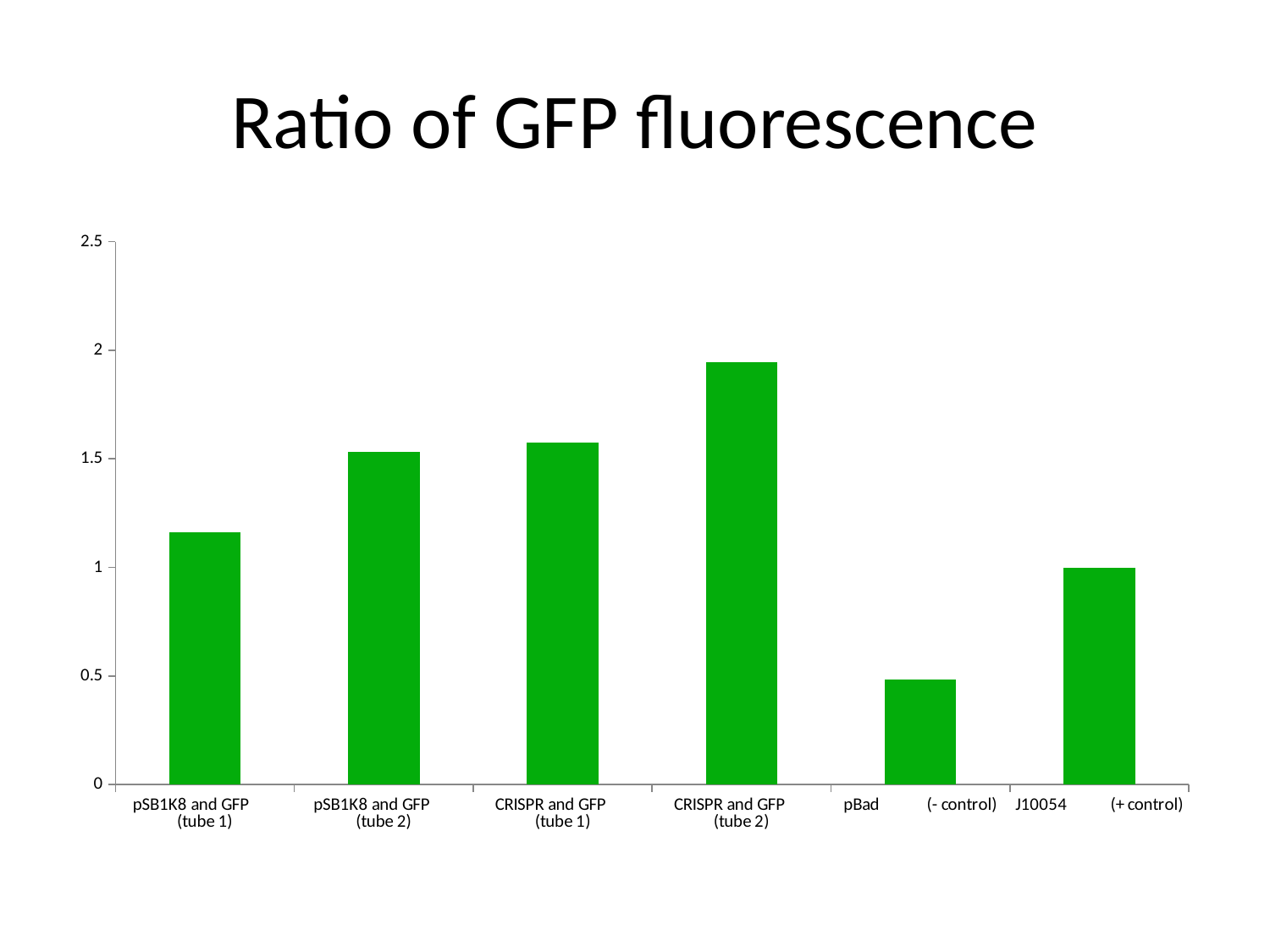
Which category has the lowest ratio of GFP fluorescence? pBad (- control) What is the title of the chart? Ratio of GFP fluorescence What colour are the bars in the chart? green What kind of chart is shown on the slide? bar chart Which is larger, the value for J10054 (+ control) or the value for pBad (- control)? J10054 (+ control) Is the value for pSB1K8 and GFP (tube 1) greater or less than 1? greater Is the value for CRISPR and GFP (tube 2) greater or less than 2? less Is the value for pSB1K8 and GFP (tube 2) greater or less than 1? greater Which category has the highest ratio of GFP fluorescence? CRISPR and GFP (tube 2) Which is larger, the value for pSB1K8 and GFP (tube 1) or the value for CRISPR and GFP (tube 1)? CRISPR and GFP (tube 1) How many bars are plotted in the chart? 6